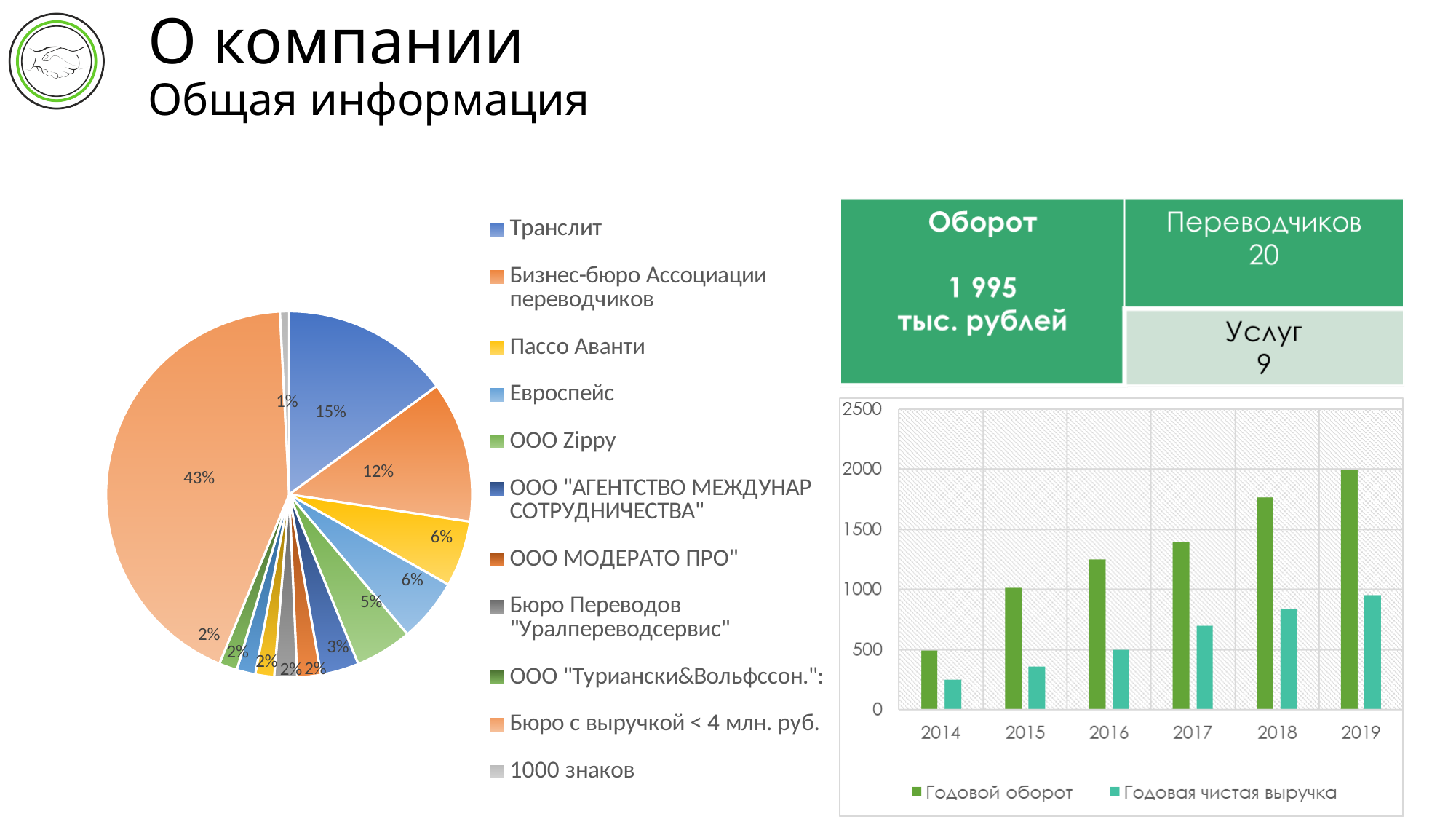
In the pie chart on the left, what share does ООО Zippy have? 5% In the bar chart on the right, is the value of Годовой оборот for 2018 greater or less than 1500? greater In the pie chart on the left, what is the share of the largest slice? 43% How many series does the legend of the bar chart on the right list? 2 In the pie chart on the left, what is the difference between the shares of Транслит and Бизнес-бюро Ассоциации переводчиков? 3% In the pie chart on the left, which category has the largest slice? Бюро с выручкой < 4 млн. руб. How many years are shown on the x axis of the bar chart on the right? 6 In the pie chart on the left, what share does Бизнес-бюро Ассоциации переводчиков have? 12% In the pie chart on the left, which is larger: the slice for Транслит or the slice for Пассо Аванти? Транслит In the pie chart on the left, what share does Транслит have? 15% What type of chart is shown on the right side of the slide? Bar chart In the bar chart on the right, does Годовой оборот rise or fall from 2014 to 2019? Rises